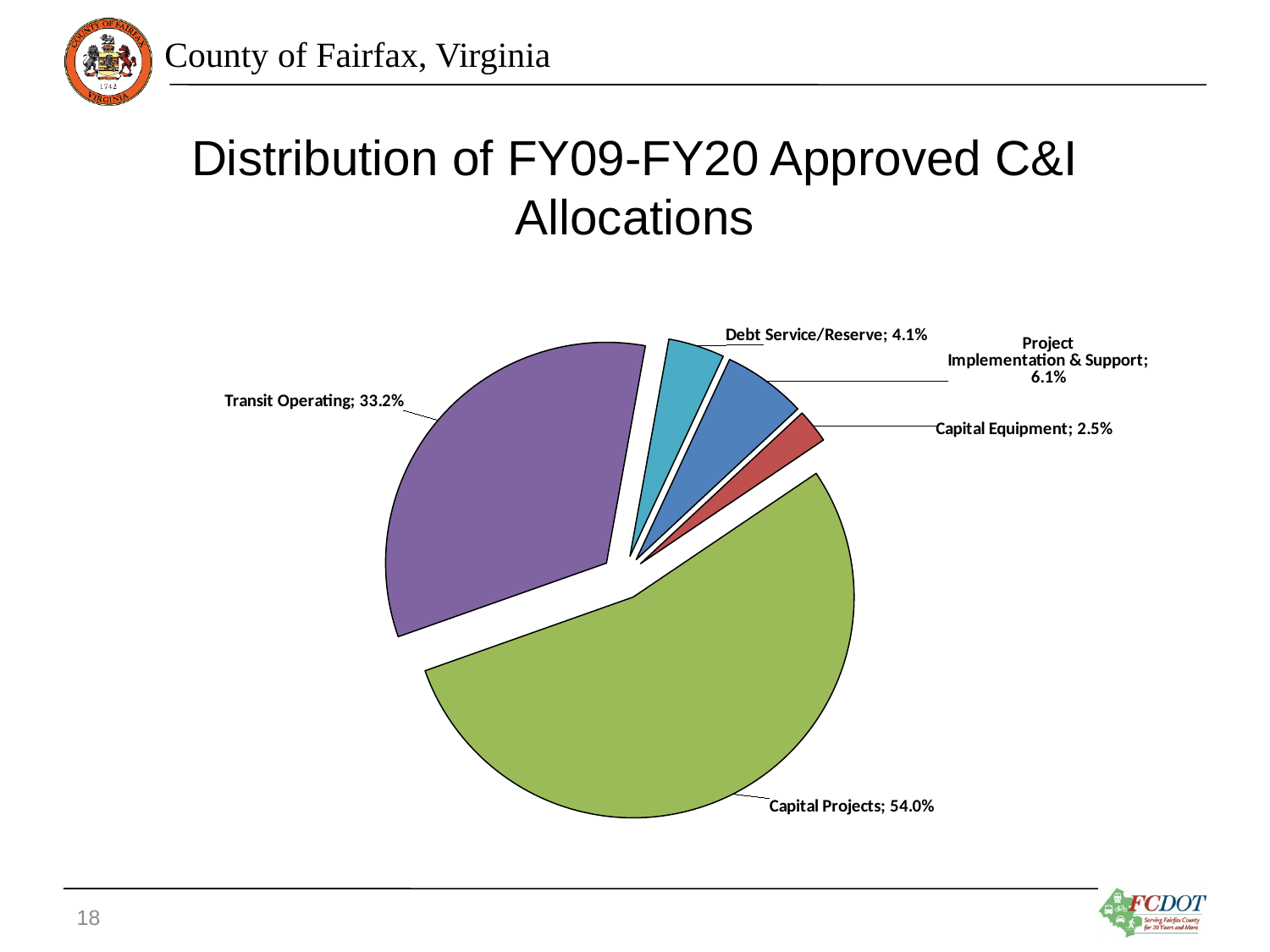
Which category has the smallest share of the pie? Capital Equipment What is the title of the slide containing the pie chart? Distribution of FY09-FY20 Approved C&I Allocations Which is larger, Debt Service/Reserve or Project Implementation & Support? Project Implementation & Support How many slices does the pie chart have? 5 What is the difference in percentage points between Capital Projects and Transit Operating? 20.8 What kind of chart is shown on the slide? Pie chart What is the value for Transit Operating? 33.2% What is the value for Project Implementation & Support? 6.1% What share of the pie does Capital Projects represent? 54.0% What is the value for Debt Service/Reserve? 4.1% Which category has the largest share of the pie? Capital Projects What is the value for Capital Equipment? 2.5%